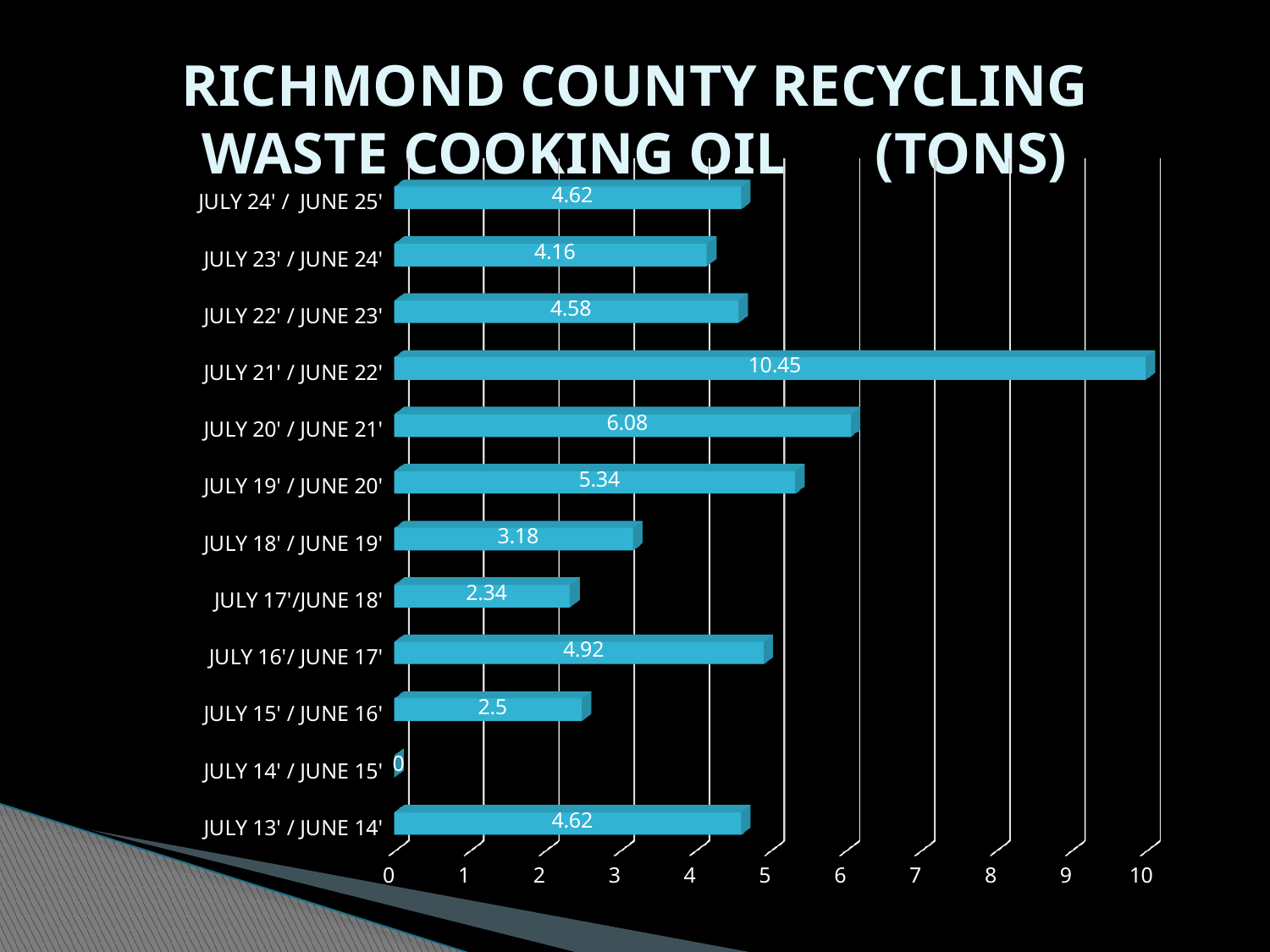
What is the title of the chart? RICHMOND COUNTY RECYCLING WASTE COOKING OIL (TONS) Which period has the lowest value? JULY 14' / JUNE 15' What kind of chart is shown on the slide? bar chart How many periods are shown on the chart? 12 Is the value for JULY 18' / JUNE 19' greater or less than 4? less Which is larger, the value for JULY 16'/ JUNE 17' or the value for JULY 22' / JUNE 23'? JULY 16'/ JUNE 17' What is the value for JULY 21' / JUNE 22'? 10.45 What is the highest value shown on the horizontal axis? 10 What is the difference between the values for JULY 20' / JUNE 21' and JULY 19' / JUNE 20'? 0.74 What is the value for JULY 24' / JUNE 25'? 4.62 What is the value for JULY 17'/JUNE 18'? 2.34 Which period has the highest value? JULY 21' / JUNE 22'